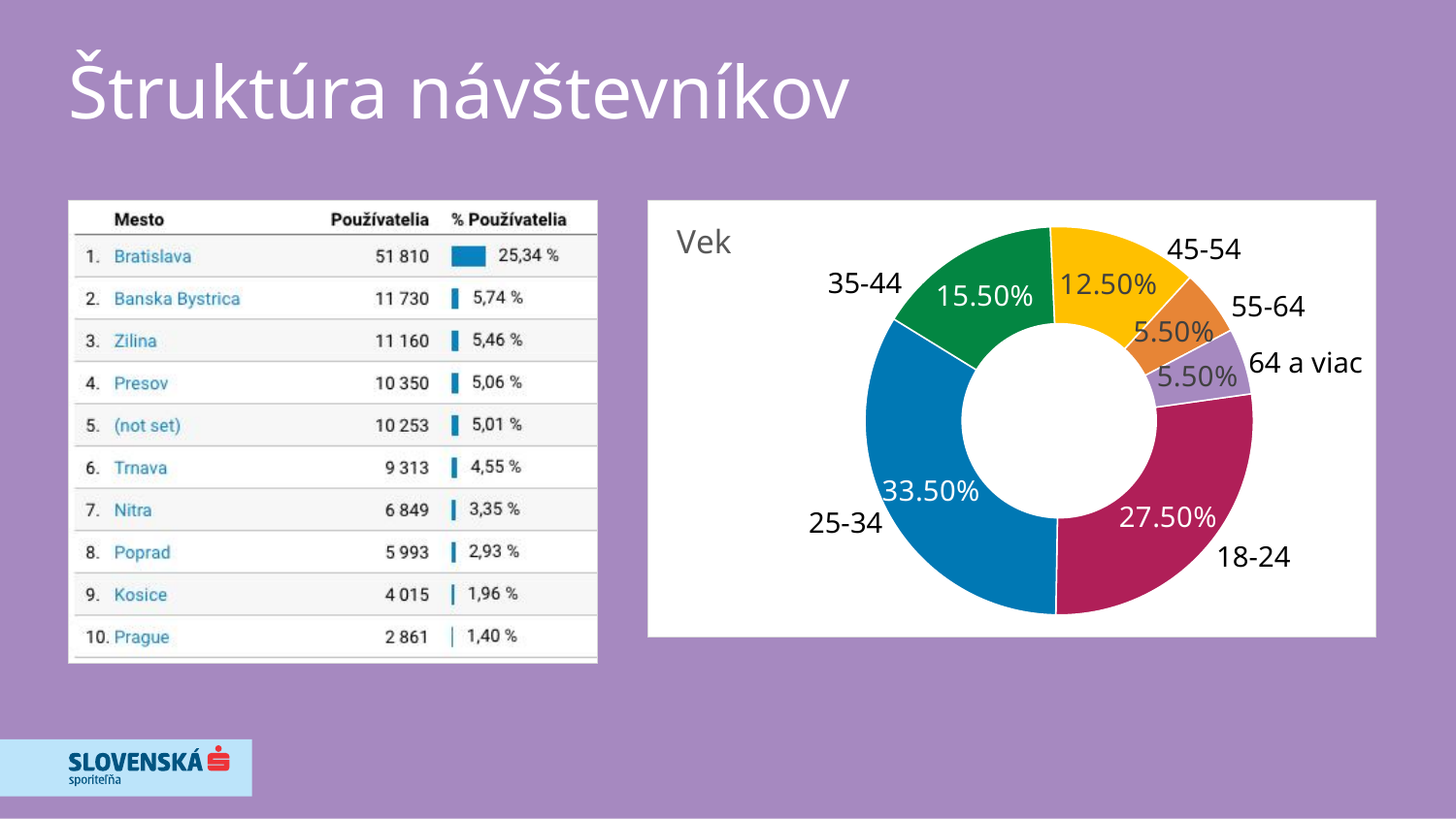
How many age groups are shown in the Vek chart? 6 In the Vek chart, what share is shown for the 18-24 age group? 27.50% In the Vek chart, what is the difference in percentage points between the 35-44 and 45-54 groups? 3 percentage points In the Vek chart, which has a larger share, 35-44 or 45-54? 35-44 In the Vek chart, what share is shown for the 55-64 age group? 5.50% What type of chart is the Vek chart? Doughnut (pie) chart In the Vek chart, what share is shown for the 25-34 age group? 33.50% In the Vek chart, what is the difference in percentage points between the 25-34 and 18-24 groups? 6 percentage points In the Vek chart, what share is shown for the 35-44 age group? 15.50% What is the title of the chart on the right side of the slide? Vek In the Vek chart, what share is shown for the 45-54 age group? 12.50% In the Vek chart, which age group has the largest share? 25-34